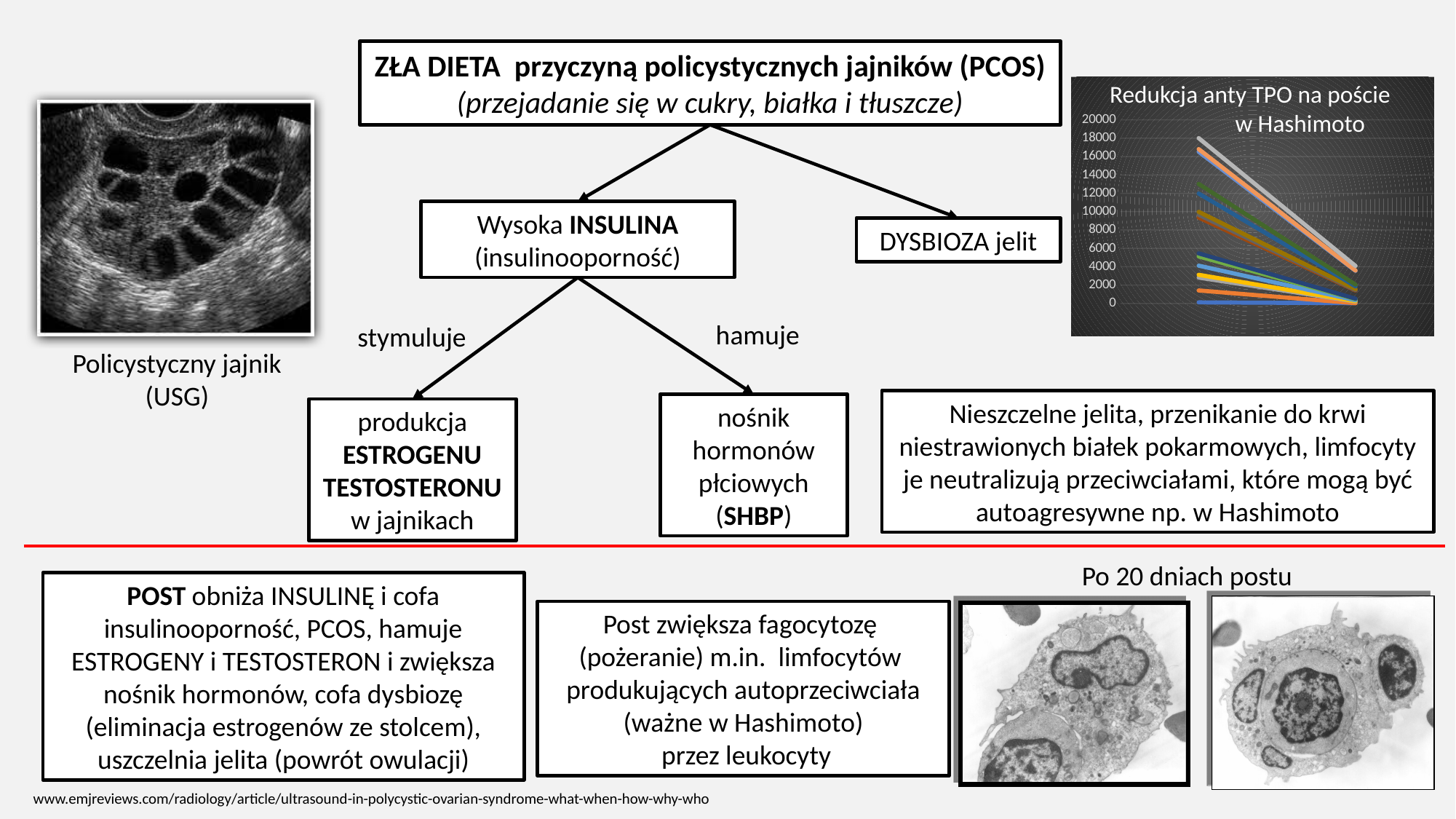
In the chart 'Redukcja anty TPO na poście w Hashimoto', are the ending values of all the lines greater or less than 6000? less In the chart 'Redukcja anty TPO na poście w Hashimoto', is the ending value of the topmost line greater or less than 8000? less What is the title of the chart in the top-right corner of the slide? Redukcja anty TPO na poście w Hashimoto In the chart 'Redukcja anty TPO na poście w Hashimoto', is the starting value of the topmost line greater or less than 16000? greater What is the highest value shown on the y axis of the chart 'Redukcja anty TPO na poście w Hashimoto'? 20000 In the chart 'Redukcja anty TPO na poście w Hashimoto', do the lines rise or fall from left to right? fall What kind of chart is shown in the top-right corner of the slide? line chart